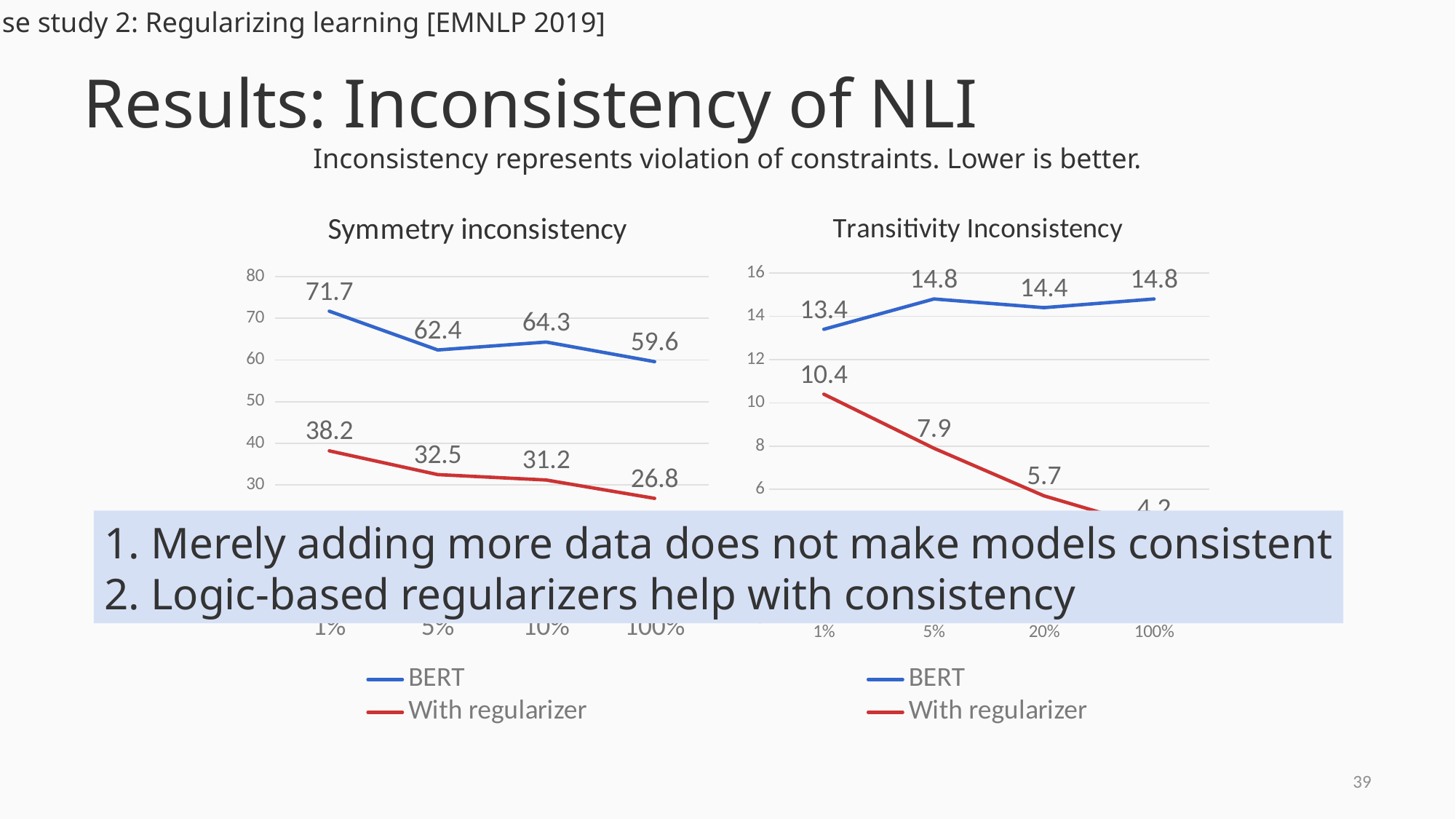
In the Symmetry inconsistency chart, what is the With regularizer value at 100%? 26.8 In the Transitivity Inconsistency chart, what is the BERT value at 20%? 14.4 How many series does the legend of the Transitivity Inconsistency chart list? 2 In the Transitivity Inconsistency chart, does the With regularizer line rise or fall from 1% to 100%? Fall In the Transitivity Inconsistency chart, at which x-axis point is the With regularizer line highest? 1% In the Symmetry inconsistency chart, which series has the larger value at 10%, BERT or With regularizer? BERT What kind of chart is the Symmetry inconsistency chart? Line chart In the Symmetry inconsistency chart, at which x-axis point is the BERT line lowest? 100% In the Symmetry inconsistency chart, what is the difference between the BERT and With regularizer values at 1%? 33.5 In the Symmetry inconsistency chart, what is the BERT value at 1%? 71.7 In the Transitivity Inconsistency chart, what is the difference between the With regularizer values at 1% and 100%? 6.2 In the Transitivity Inconsistency chart, what is the With regularizer value at 5%? 7.9